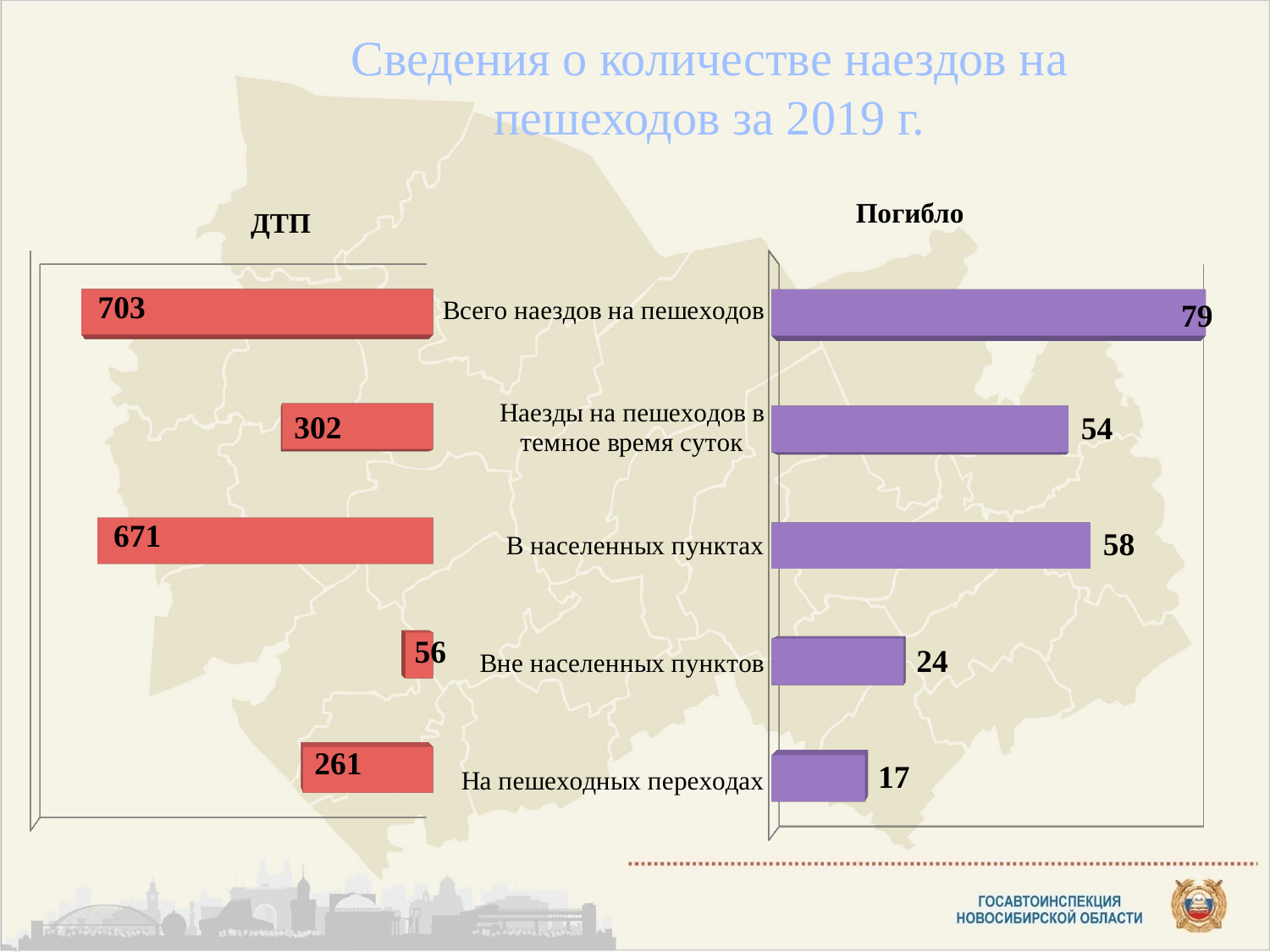
In the Погибло chart, which is larger: the value for В населенных пунктах or the value for Наезды на пешеходов в темное время суток? В населенных пунктах What kind of chart is the Погибло chart? bar chart In the ДТП chart, what is the value for Всего наездов на пешеходов? 703 How many categories are shown in the ДТП chart? 5 In the Погибло chart, which category has the highest value? Всего наездов на пешеходов In the ДТП chart, which category has the lowest value? Вне населенных пунктов In the ДТП chart, what is the value for На пешеходных переходах? 261 In the Погибло chart, which category has the lowest value? На пешеходных переходах In the Погибло chart, what is the value for В населенных пунктах? 58 What colour are the bars in the ДТП chart? red In the Погибло chart, what is the difference between the values for Наезды на пешеходов в темное время суток and Вне населенных пунктов? 30 In the ДТП chart, what is the difference between the values for В населенных пунктах and Вне населенных пунктов? 615